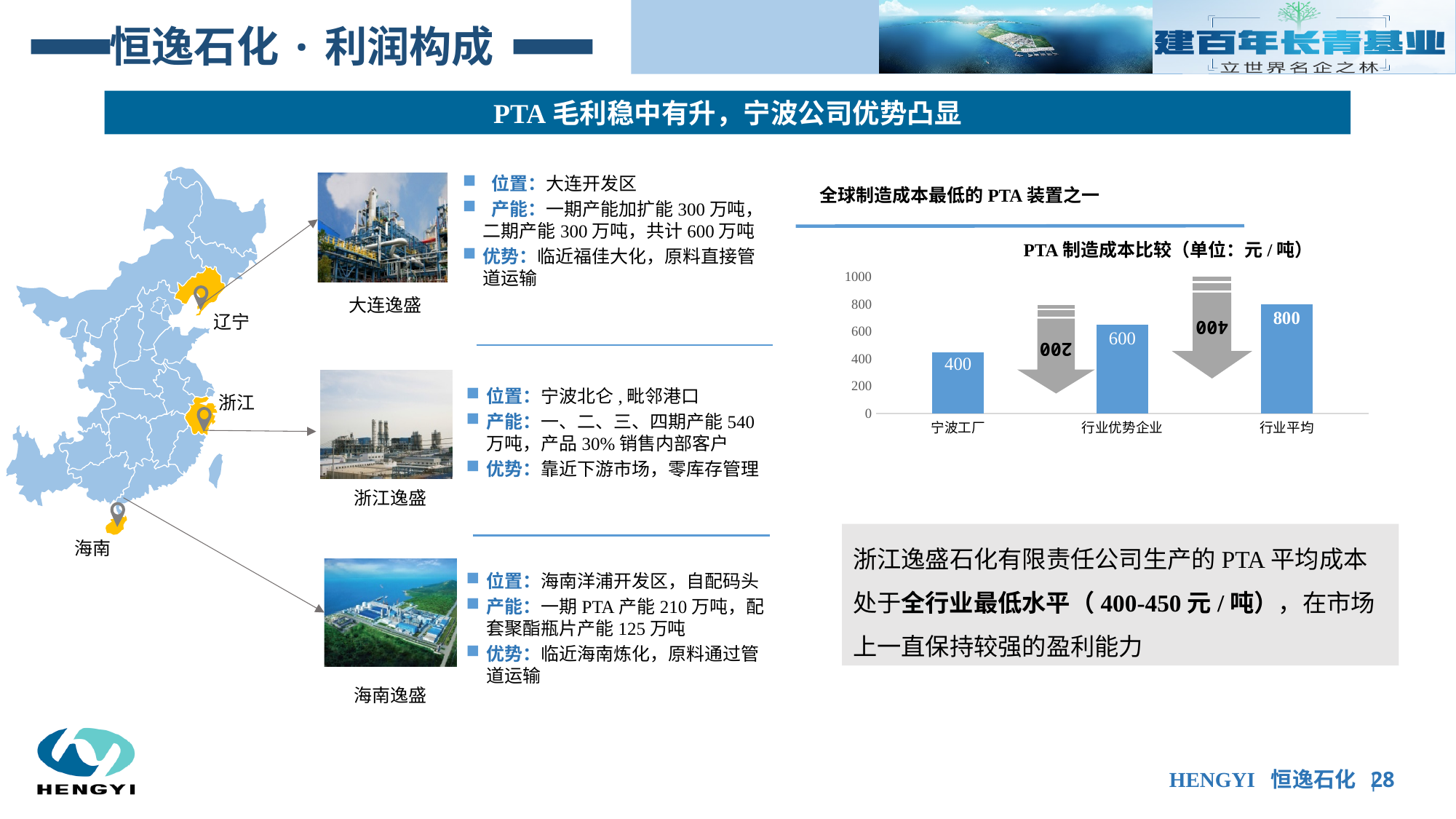
What is the difference in PTA manufacturing cost between 行业平均 and 宁波工厂? 400 What is the PTA manufacturing cost for 行业平均 in the chart? 800 How many categories are shown in the PTA manufacturing cost chart? 3 What is the PTA manufacturing cost for 宁波工厂 in the chart? 400 Do the values in the PTA manufacturing cost chart rise or fall from left to right? rise What unit is stated in the title of the PTA manufacturing cost chart? 元/吨 What kind of chart is the PTA 制造成本比较 chart? bar chart Which category has the highest PTA manufacturing cost in the chart? 行业平均 Which category has the lowest PTA manufacturing cost in the chart? 宁波工厂 Which has a higher PTA manufacturing cost, 宁波工厂 or 行业优势企业? 行业优势企业 What is the difference in PTA manufacturing cost between 行业优势企业 and 宁波工厂? 200 What is the PTA manufacturing cost for 行业优势企业 in the chart? 600